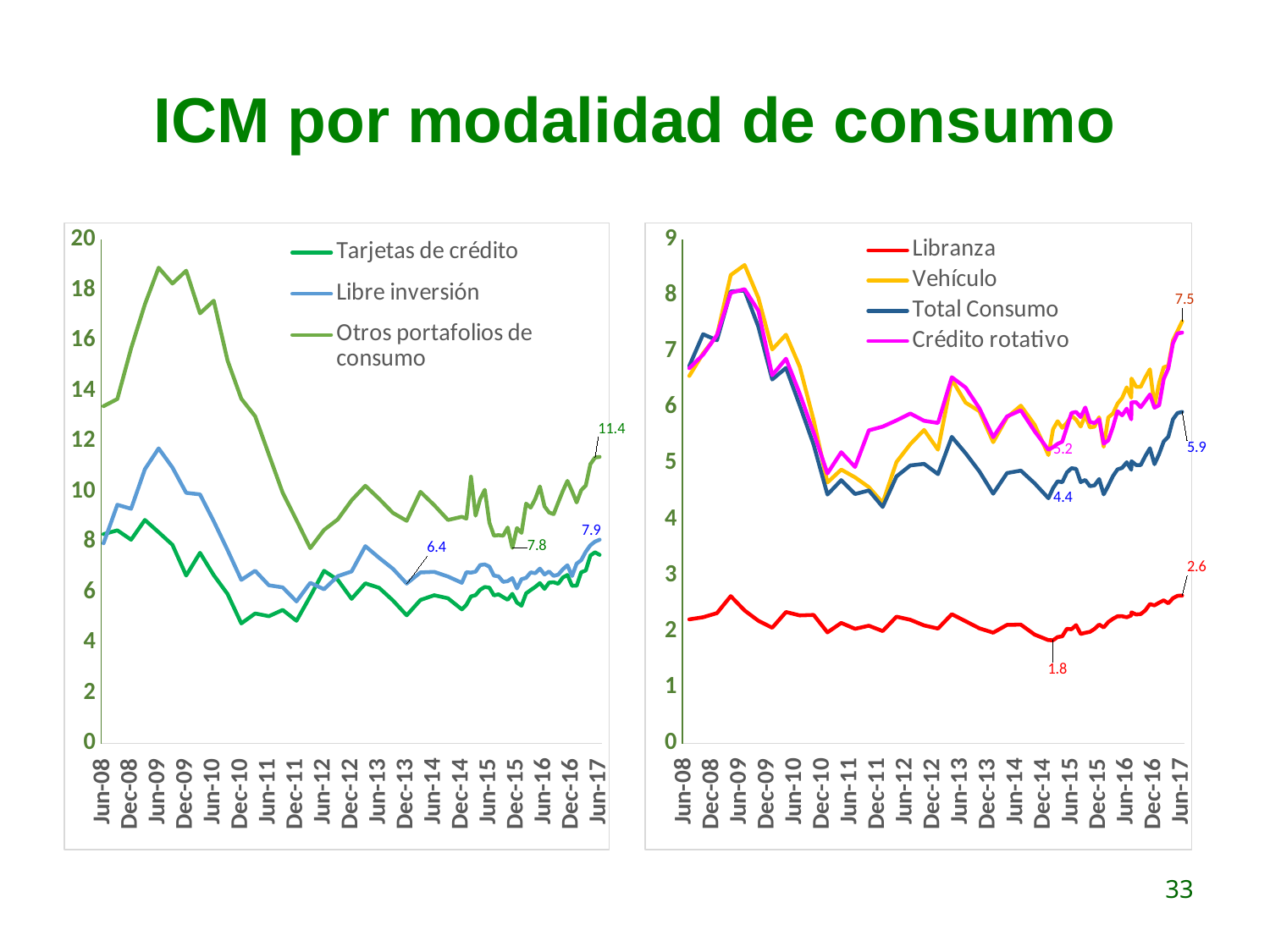
In the left chart, what is the labelled value of Otros portafolios de consumo at Jun-17? 11.4 In the right chart, what is the lowest labelled value of Libranza, shown near Dec-14? 1.8 In the left chart, what is the labelled value of Libre inversión at Jun-17? 7.9 In the right chart, what is the labelled value of Total Consumo at Jun-17? 5.9 In the right chart, what is the labelled value of Libranza at Jun-17? 2.6 In the left chart, is the value of Tarjetas de crédito at Dec-10 greater or less than 6? less In the left chart, which series has the highest value at Jun-17? Otros portafolios de consumo In the right chart, which series has the lowest values across the whole period? Libranza How many series does the legend of the right chart list? 4 In the right chart, what is the difference between the Jun-17 values of Total Consumo (5.9) and Libranza (2.6)? 3.3 How many series does the legend of the left chart list? 3 What kind of chart is the left chart on the slide? line chart